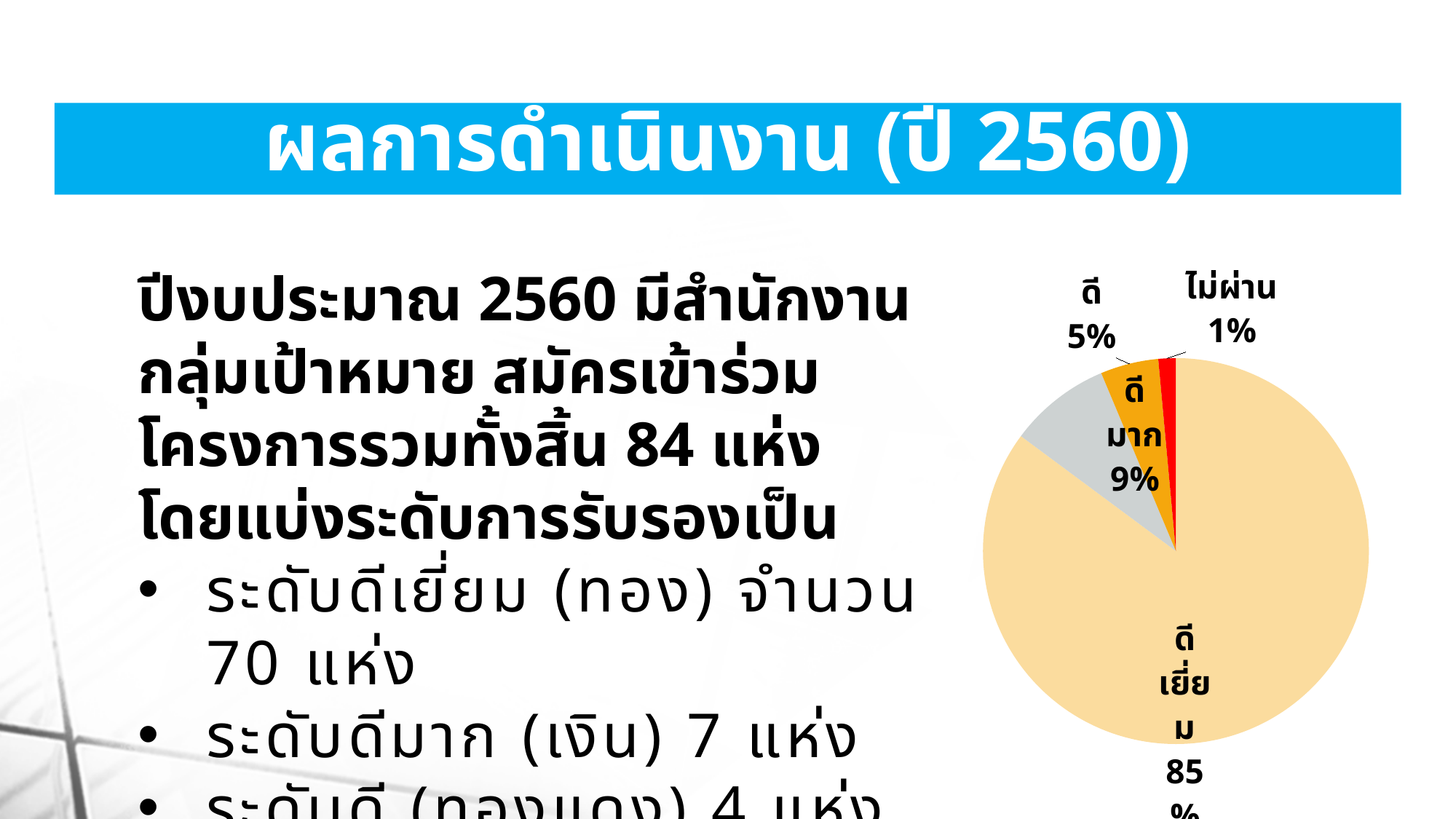
How many slices does the pie chart have? 4 What kind of chart is shown on the slide? pie chart What share of the pie does ดีมาก have? 9% What colour is the ดีมาก slice of the pie chart? orange What share of the pie does ดีเยี่ยม have? 85% What share of the pie does ไม่ผ่าน have? 1% What colour is the ไม่ผ่าน slice of the pie chart? red Which slice of the pie chart is the smallest? ไม่ผ่าน What is the difference in percentage points between the ดีมาก slice and the ดี slice? 4 Which slice of the pie chart is the largest? ดีเยี่ยม Which is larger, the ดี slice or the ไม่ผ่าน slice? ดี